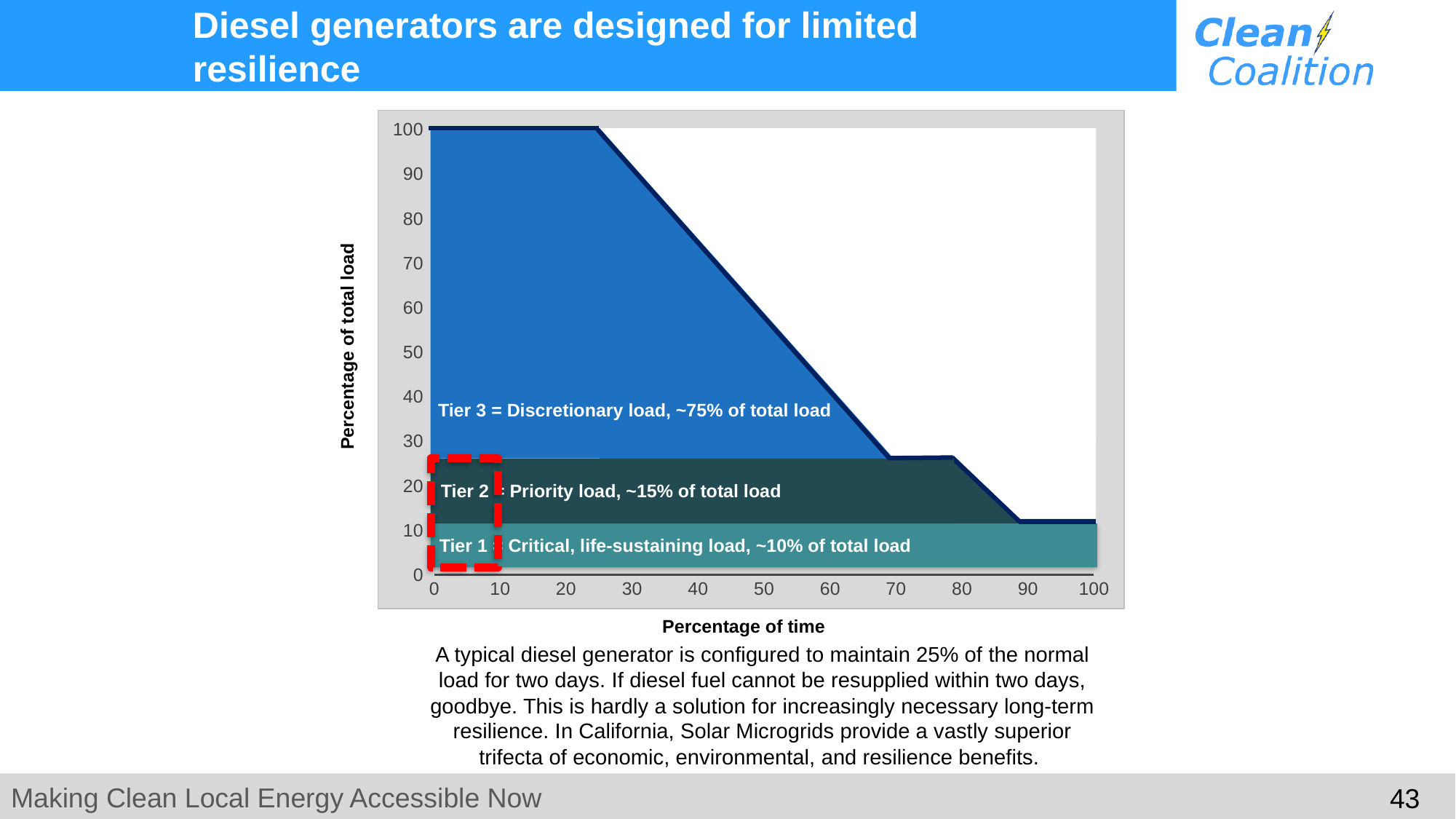
What is the percentage of total load at 0 percent of time? 100 Is the percentage of total load at 75 percent of time greater or less than 30? less Does the plotted percentage of total load rise or fall as the percentage of time increases? fall What kind of chart is shown on the slide? area chart What is the title of the x axis of the chart? Percentage of time According to the label on the chart, what share of total load is Tier 1, the critical, life-sustaining load? ~10% Is the percentage of total load at 100 percent of time greater or less than 20? less What is the title of the y axis of the chart? Percentage of total load Is the percentage of total load at 50 percent of time greater or less than 70? less What is the percentage of total load at 10 percent of time? 100 How many load tiers are labelled on the chart? 3